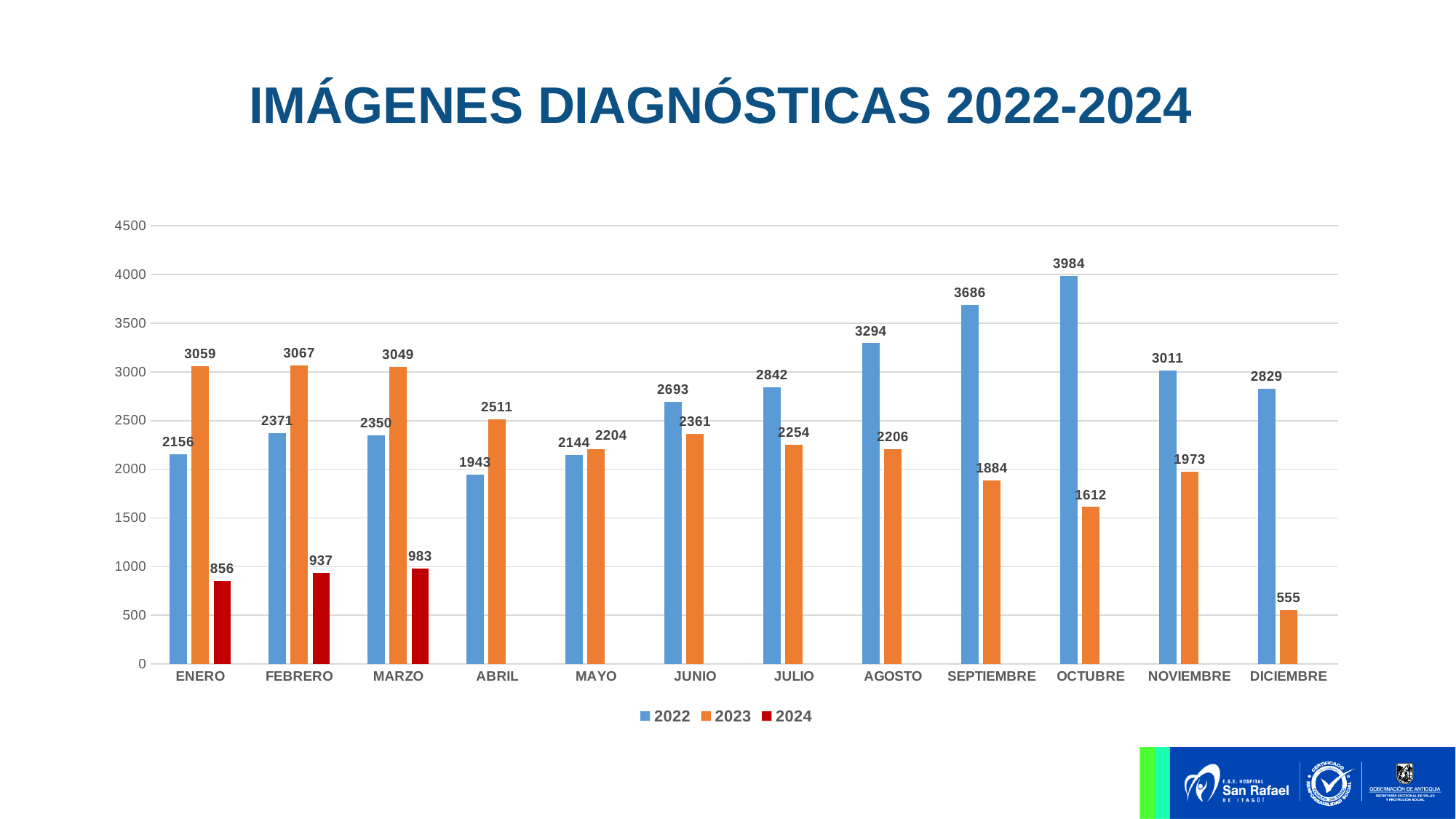
What is the value for 2022 in OCTUBRE? 3984 What is the difference between the 2023 and 2022 values in ENERO? 903 Which month has the highest value for the 2022 series? OCTUBRE How many series does the legend list? 3 What is the title of the chart? IMÁGENES DIAGNÓSTICAS 2022-2024 Which is larger in SEPTIEMBRE, the 2022 value or the 2023 value? 2022 What is the value for 2024 in MARZO? 983 What is the value for 2023 in ABRIL? 2511 What kind of chart is shown on the slide? Bar chart Which month has the lowest value for the 2023 series? DICIEMBRE Does the 2024 series rise or fall from ENERO to MARZO? Rise How many months are shown on the x axis? 12